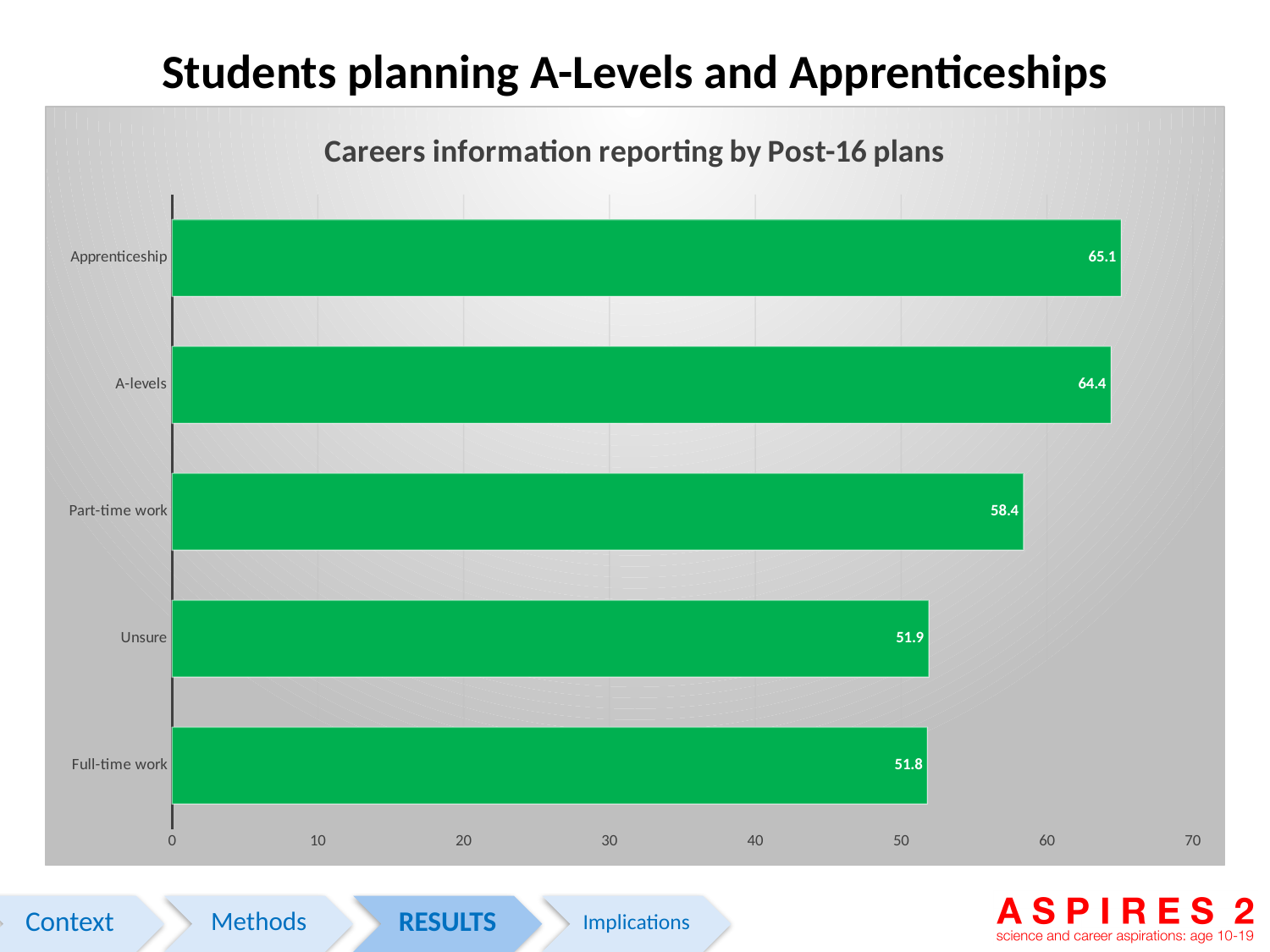
Is the value for Unsure greater or less than 60? less What is the difference between the values for A-levels and Unsure? 12.5 What kind of chart is shown on the slide? Bar chart How many categories are shown in the chart? 5 What is the value for Full-time work? 51.8 What is the title of the chart? Careers information reporting by Post-16 plans What is the difference between the values for Apprenticeship and Part-time work? 6.7 What is the value for Part-time work? 58.4 Which is larger, the value for A-levels or the value for Part-time work? A-levels Which category has the highest value? Apprenticeship What is the value for Apprenticeship? 65.1 Which category has the lowest value? Full-time work